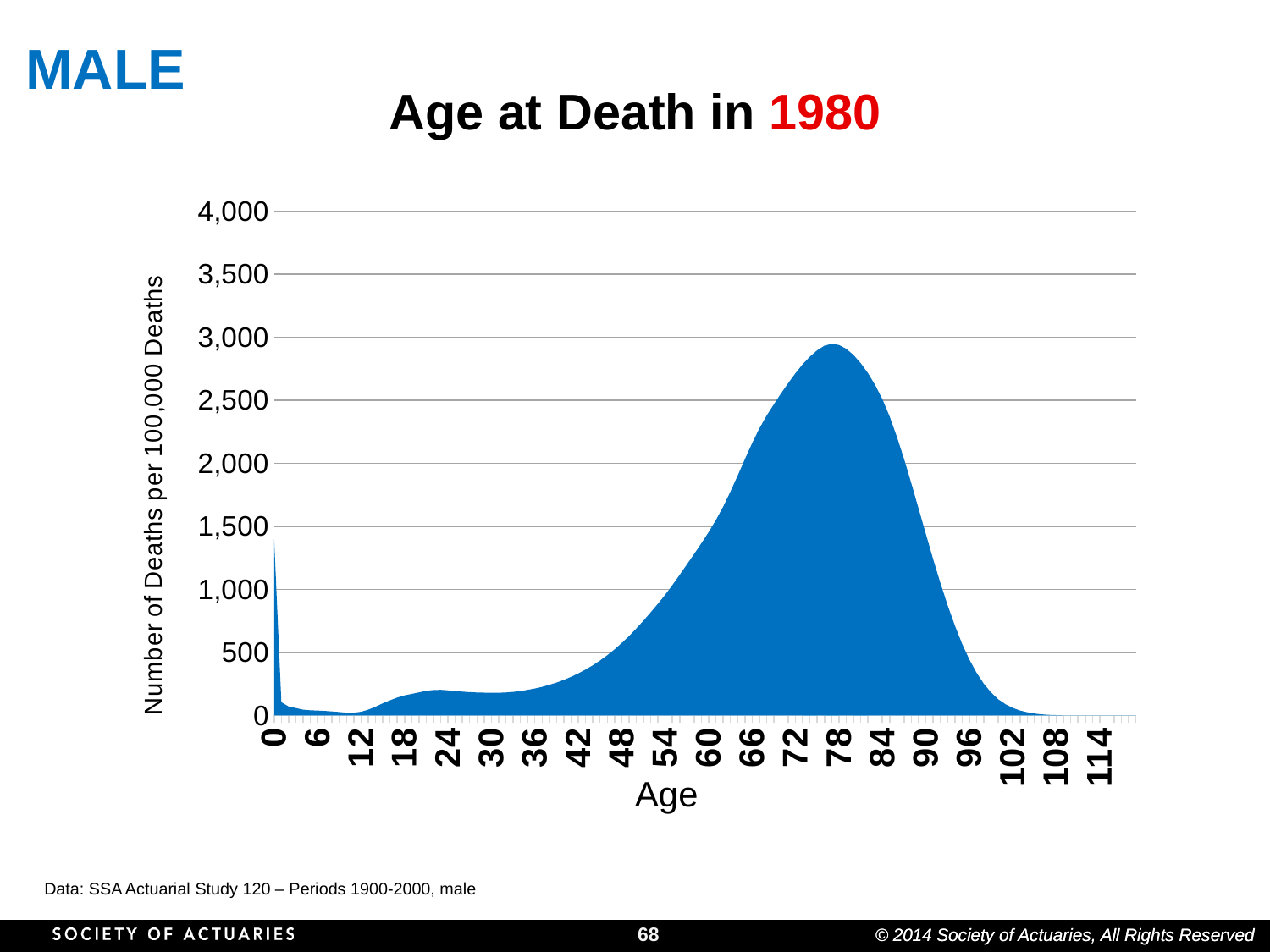
What is the title of the chart? Age at Death in 1980 Do the values rise or fall as age increases from 78 to 108? Fall Is the value at age 24 greater or less than 500? less Do the values rise or fall as age increases from 48 to 78? Rise Is the value at age 78 greater or less than 2,500? greater What kind of chart is shown on the slide? Area chart What is the label of the vertical axis? Number of Deaths per 100,000 Deaths Is the value at age 60 greater or less than 1,000? greater Which has the larger value, age 78 or age 24? Age 78